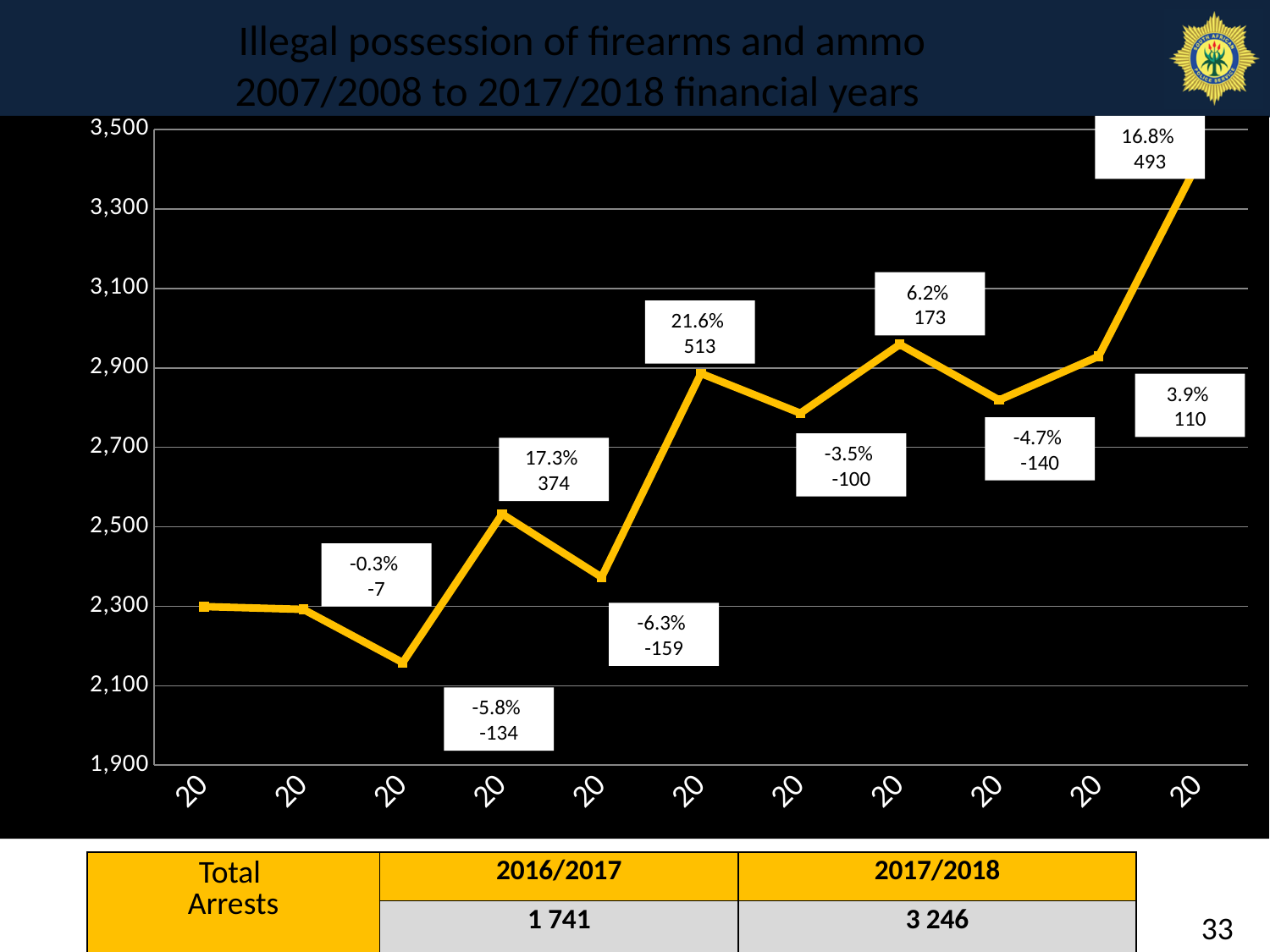
What absolute change accompanies the 16.8% label? 493 What kind of chart is shown on the slide? line chart Which is larger, the absolute change labelled 513 or the absolute change labelled 374? 513 How many data points are plotted on the line? 11 What is the most negative percentage change shown in the data labels? -6.3% What is the lowest value shown on the y axis? 1,900 What is the largest percentage change shown in the data labels? 21.6% Is the value of the last (rightmost) point greater or less than 3,300? greater Overall, do the values rise or fall from the first point to the last point along the x axis? rise How many data labels show a negative percentage change? 5 What is the title of the chart? Illegal possession of firearms and ammo 2007/2008 to 2017/2018 financial years Is the value of the first (leftmost) point greater or less than 2,500? less